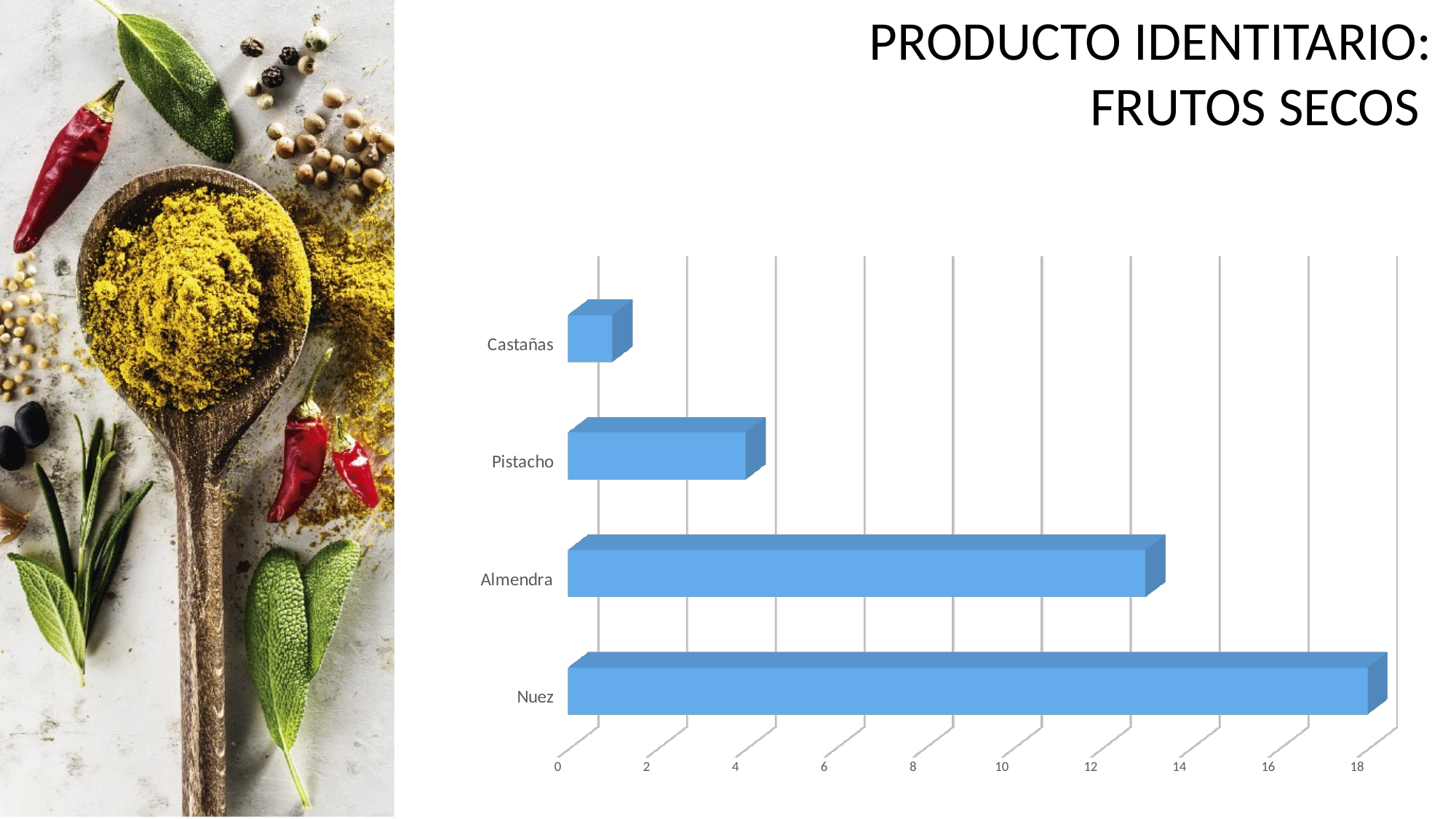
Which has a larger value, Castañas or Pistacho? Pistacho Is the value for Pistacho greater or less than 6? less Which category has the lowest value in the chart? Castañas Is the value for Castañas greater or less than 2? less Which has a larger value, Almendra or Pistacho? Almendra Which category has the highest value in the chart? Nuez How many categories are shown in the chart? 4 Is the value for Almendra greater or less than 14? less What is the highest value shown on the horizontal axis of the chart? 18 What kind of chart is shown on the slide? bar chart